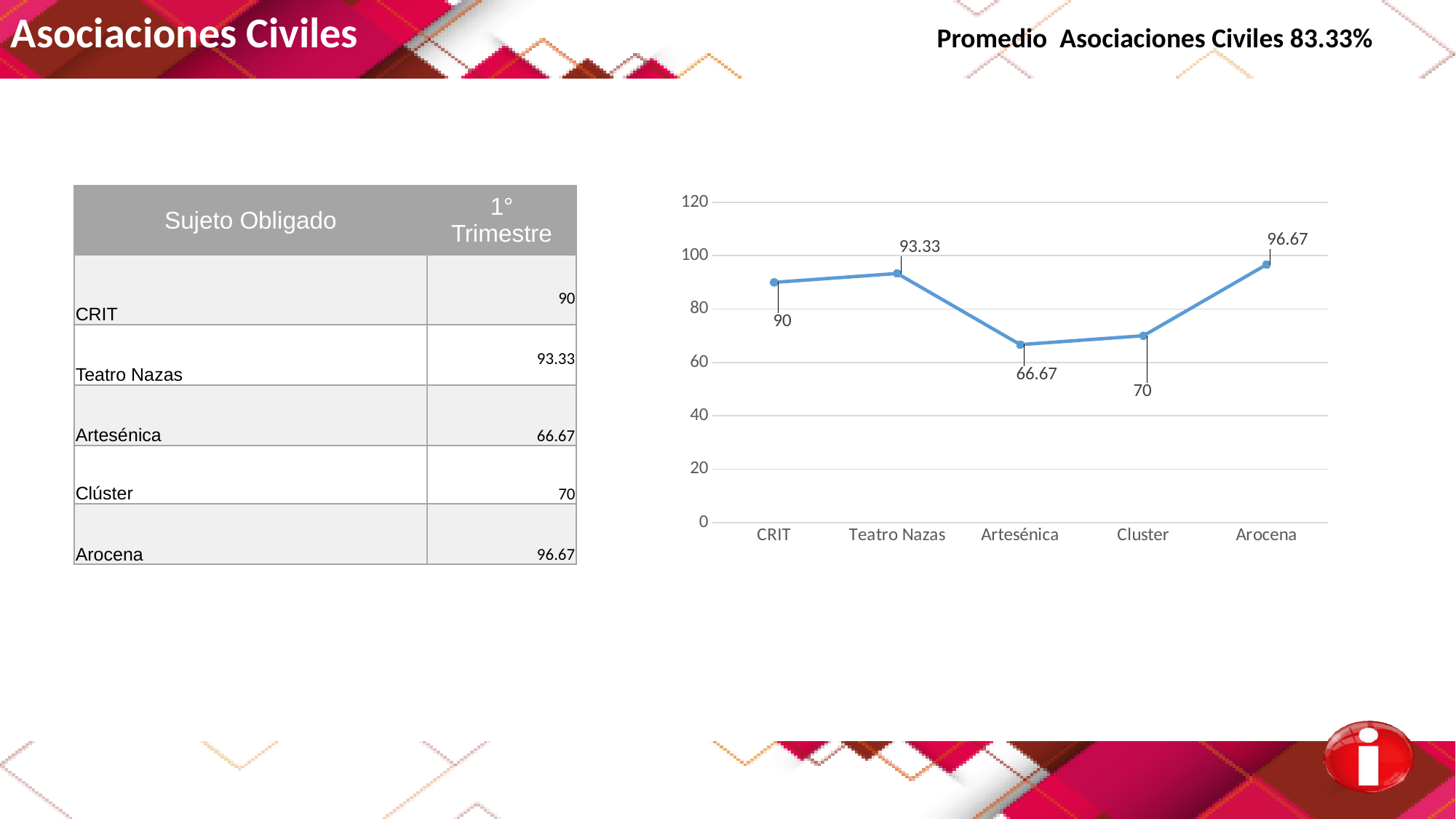
What is the value for Teatro Nazas in the line chart? 93.33 What is the difference between the values for Teatro Nazas and CRIT? 3.33 What is the value for Cluster in the line chart? 70 How many categories are plotted on the x axis of the line chart? 5 Which is larger, the value for CRIT or the value for Cluster? CRIT Which category has the lowest value in the line chart? Artesénica What kind of chart is shown on the slide? line chart What is the difference between the values for Arocena and Artesénica? 30 What is the highest tick value shown on the y axis of the chart? 120 Which category has the highest value in the line chart? Arocena What is the value for Artesénica in the line chart? 66.67 Is the value for Arocena greater or less than 80? greater